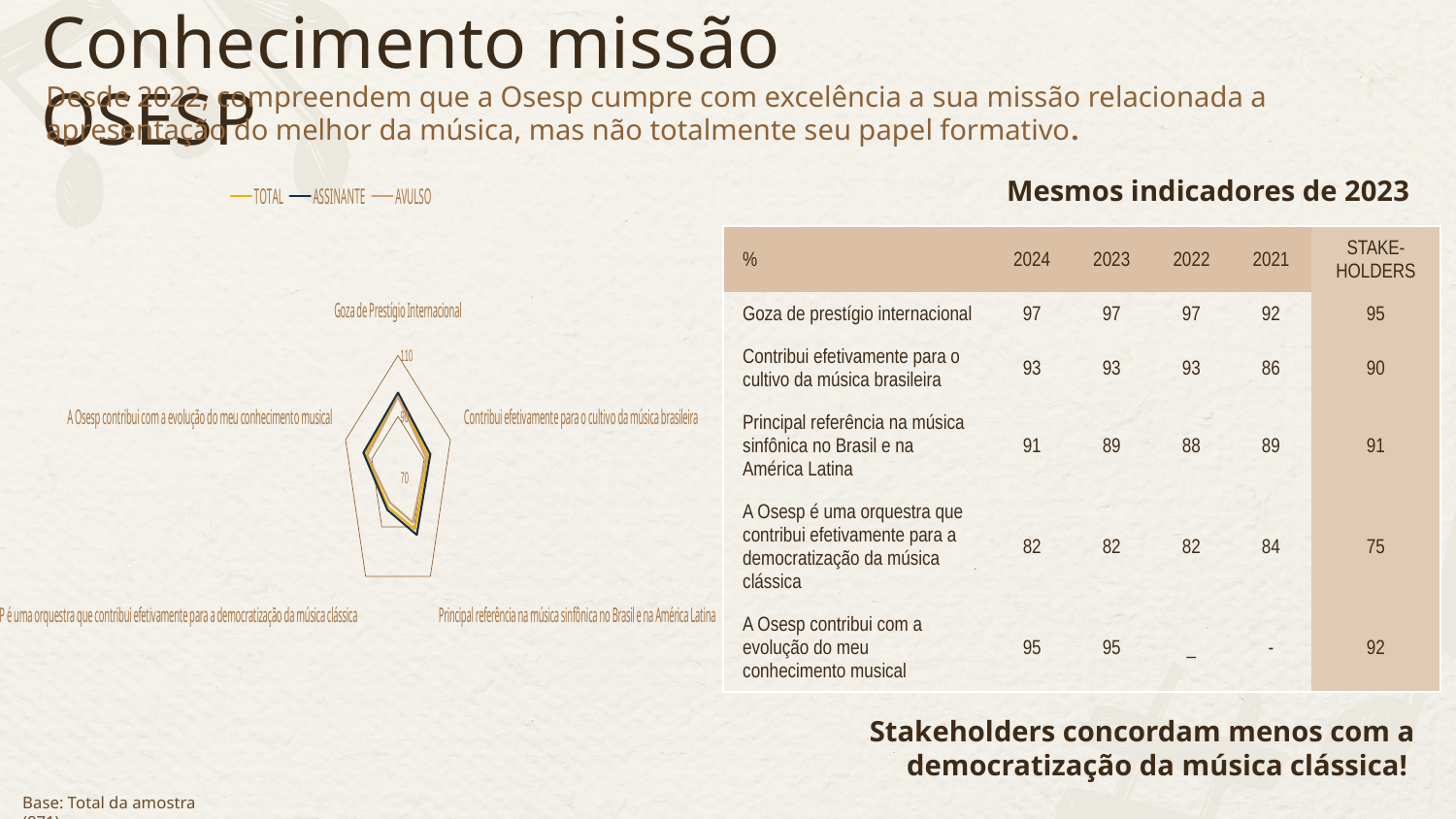
In the table, what is the STAKEHOLDERS value for 'A Osesp é uma orquestra que contribui efetivamente para a democratização da música clássica'? 75 In the table, is the 2024 value for 'Principal referência na música sinfônica no Brasil e na América Latina' larger or smaller than its 2023 value? larger What is the highest axis tick value shown on the radar chart? 110 Which series are listed in the legend of the radar chart? TOTAL, ASSINANTE, AVULSO In the table, which indicator has the lowest 2024 value? A Osesp é uma orquestra que contribui efetivamente para a democratização da música clássica On the radar chart, is the value for Goza de Prestígio Internacional greater or less than 70? greater In the table, what is the difference between the 2024 and 2021 values for 'Contribui efetivamente para o cultivo da música brasileira'? 7 How many series does the legend of the radar chart list? 3 How many categories (axes) does the radar chart have? 5 On the radar chart, is the value for Goza de Prestígio Internacional greater or less than 110? less What kind of chart is shown on the left of the slide? Radar chart In the table, what is the 2024 value for Goza de prestígio internacional? 97